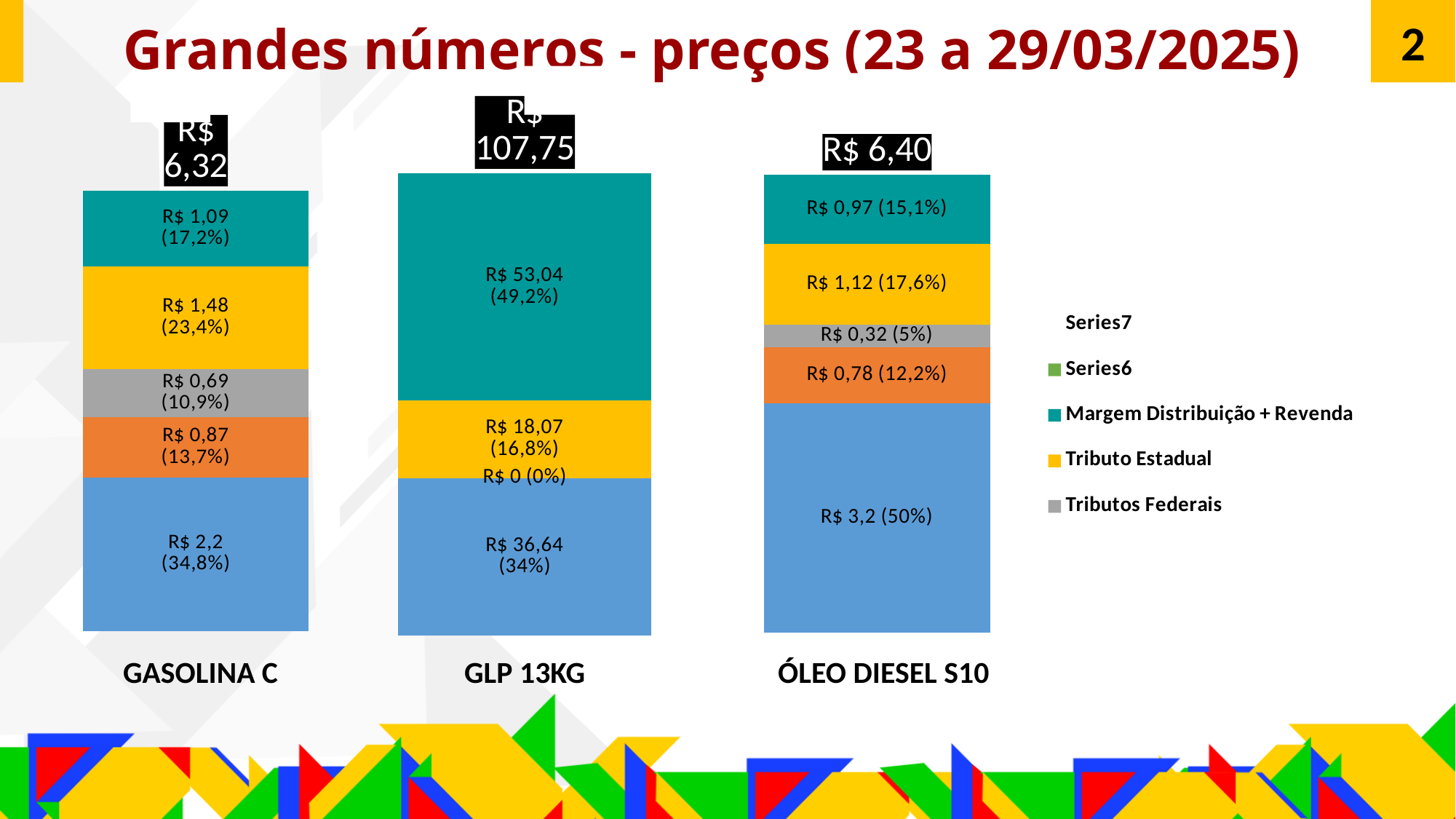
What is the value of Tributos Federais for ÓLEO DIESEL S10? R$ 0,32 (5%) How many fuel categories are plotted on the chart? 3 How many series does the legend list? 5 Which category has the highest total price? GLP 13KG What is the value of Tributo Estadual for GLP 13KG? R$ 18,07 (16,8%) What kind of chart is shown on the slide? Stacked bar chart What is the value of Tributos Federais for GLP 13KG? R$ 0 (0%) What is the total price shown above the GLP 13KG bar? R$ 107,75 What is the total price shown above the GASOLINA C bar? R$ 6,32 What is the value of Margem Distribuição + Revenda for GASOLINA C? R$ 1,09 (17,2%) Which has the larger Tributo Estadual value, GASOLINA C or ÓLEO DIESEL S10? GASOLINA C What percentage share of the GLP 13KG price is Margem Distribuição + Revenda? 49,2%